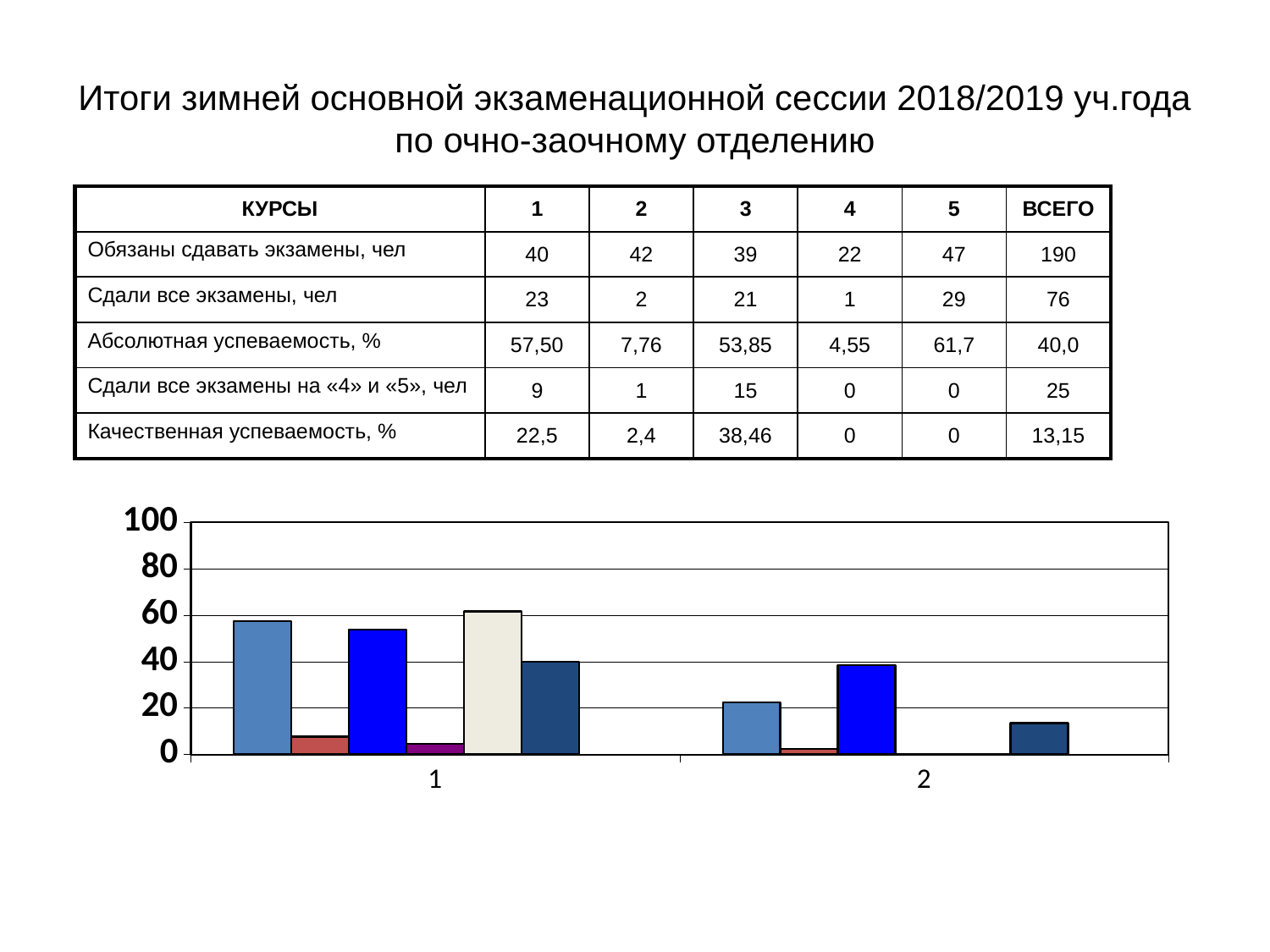
Which category has the taller light blue (first) bar, 1 or 2? 1 In which category does the tallest bar of the whole chart appear? 1 What is the highest value shown on the chart's vertical axis? 100 How many categories are shown on the x axis of the chart? 2 What kind of chart is shown on the slide? bar chart How many bars are plotted in category 1 of the chart? 6 Is the value of the light blue (first) bar in category 1 greater or less than 40? greater Is the value of the light blue (first) bar in category 2 greater or less than 40? less Is the value of the red (second) bar in category 1 greater or less than 20? less